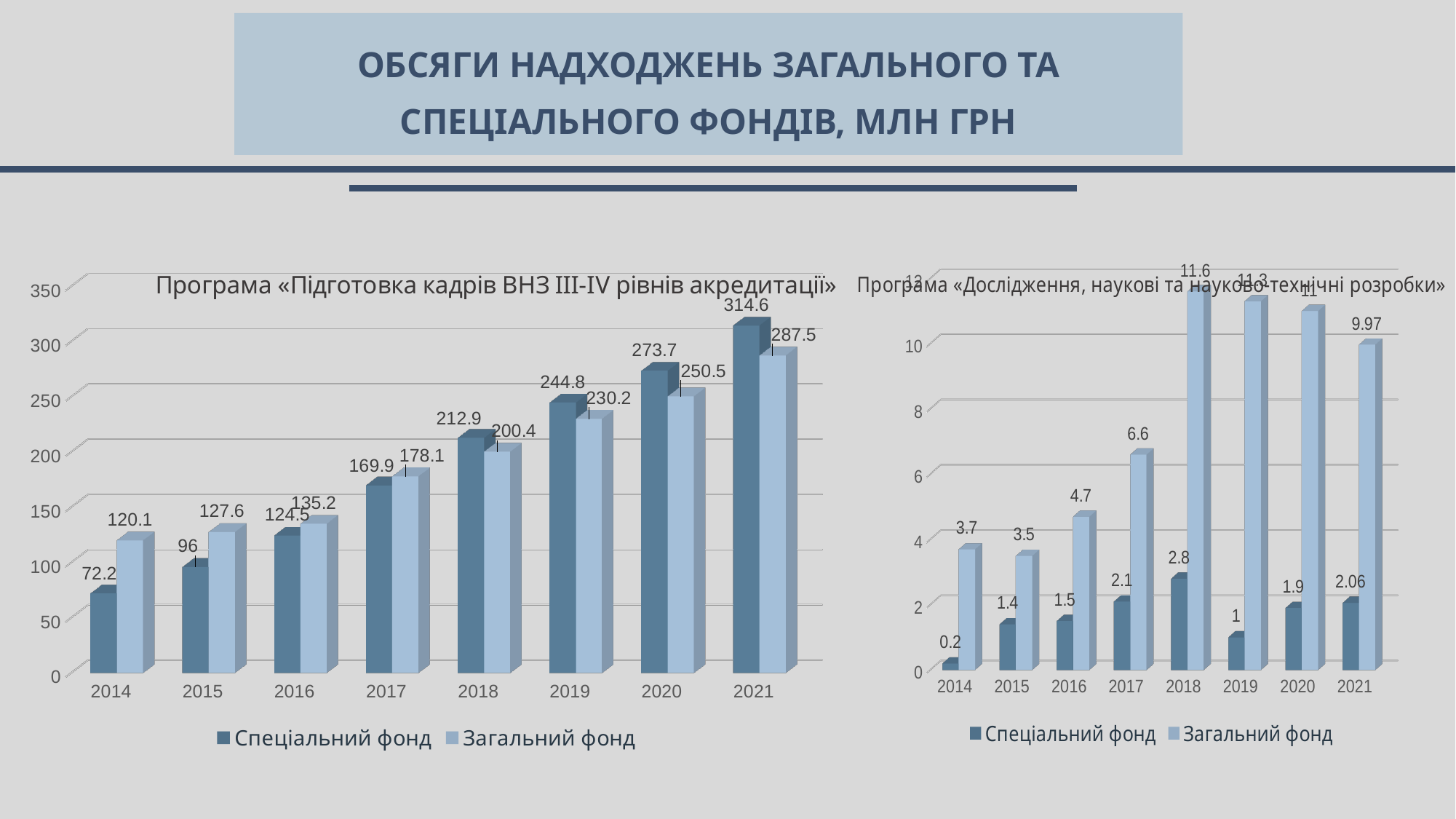
What type of chart is the left chart (Програма «Підготовка кадрів ВНЗ III-IV рівнів акредитації»)? bar chart In the left chart (Програма «Підготовка кадрів ВНЗ III-IV рівнів акредитації»), does the Спеціальний фонд value rise or fall from 2014 to 2021? rise In the right chart (Програма «Дослідження, наукові та науково-технічні розробки»), what is the value of Загальний фонд in 2018? 11.6 In the left chart (Програма «Підготовка кадрів ВНЗ III-IV рівнів акредитації»), what is the difference between Спеціальний фонд and Загальний фонд in 2021? 27.1 In the left chart (Програма «Підготовка кадрів ВНЗ III-IV рівнів акредитації»), what is the value of Загальний фонд in 2014? 120.1 In the left chart (Програма «Підготовка кадрів ВНЗ III-IV рівнів акредитації»), which year has the lowest Спеціальний фонд value? 2014 How many series does the legend of the right chart (Програма «Дослідження, наукові та науково-технічні розробки») list? 2 In the left chart (Програма «Підготовка кадрів ВНЗ III-IV рівнів акредитації»), what is the value of Спеціальний фонд in 2021? 314.6 In the right chart (Програма «Дослідження, наукові та науково-технічні розробки»), which year has the highest Спеціальний фонд value? 2018 In the left chart (Програма «Підготовка кадрів ВНЗ III-IV рівнів акредитації»), which is larger in 2016: Спеціальний фонд or Загальний фонд? Загальний фонд How many years are shown on the x axis of the left chart (Програма «Підготовка кадрів ВНЗ III-IV рівнів акредитації»)? 8 In the right chart (Програма «Дослідження, наукові та науково-технічні розробки»), what is the value of Спеціальний фонд in 2021? 2.06